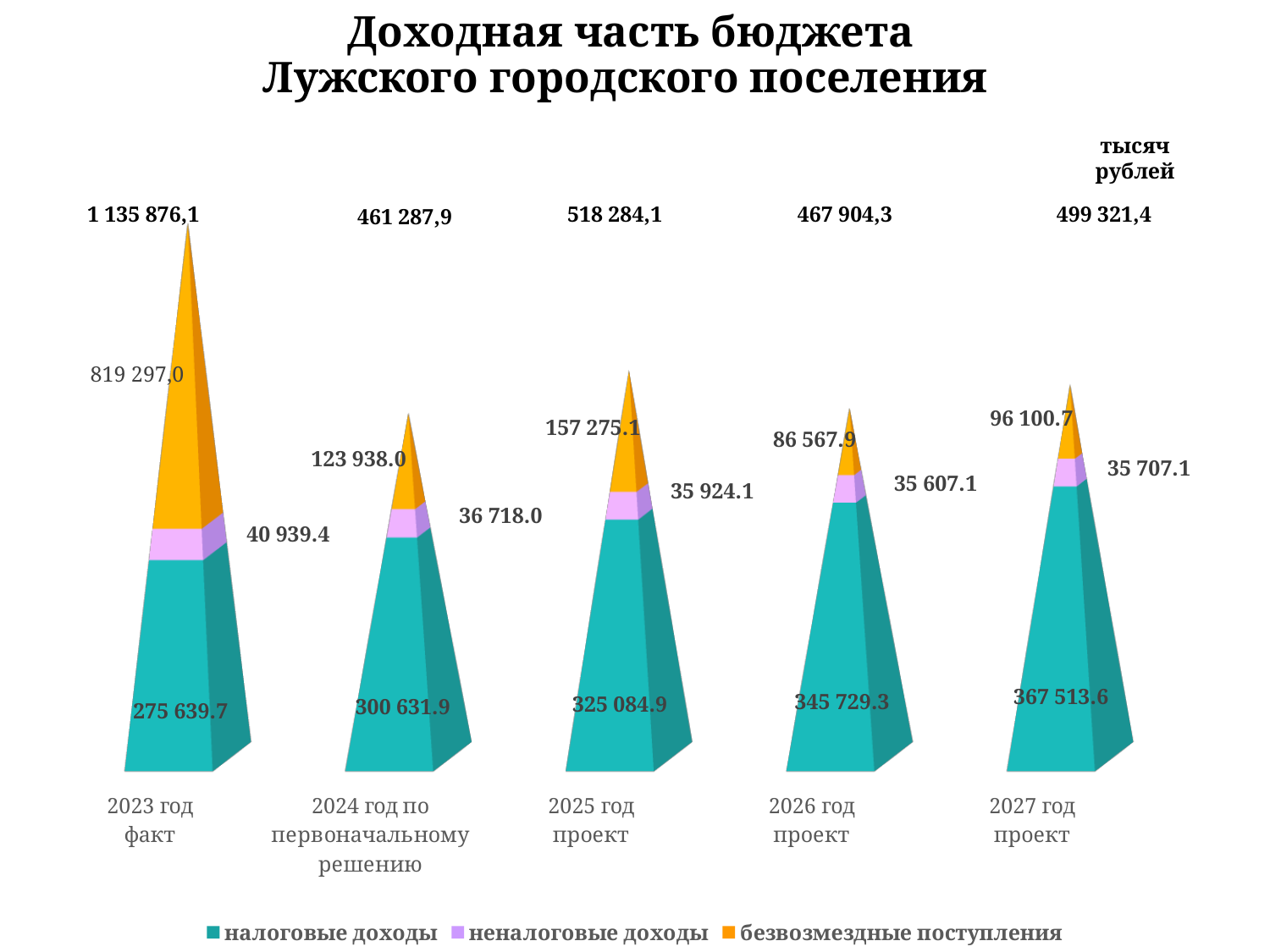
Which category has the highest value of безвозмездные поступления? 2023 год факт What is the total shown above the bar for 2027 год проект? 499 321,4 Which category has the lowest value of налоговые доходы? 2023 год факт What is the value of безвозмездные поступления for 2023 год факт? 819 297,0 What kind of chart is this? Stacked bar chart What is the value of налоговые доходы for 2025 год проект? 325 084.9 Which is larger: безвозмездные поступления for 2025 год проект or for 2026 год проект? 2025 год проект How many categories are shown on the x axis? 5 What is the difference between налоговые доходы for 2027 год проект and 2023 год факт? 91 873.9 Do the values of налоговые доходы rise or fall from 2023 to 2027? Rise How many series does the legend list? 3 What is the value of неналоговые доходы for 2024 год по первоначальному решению? 36 718.0